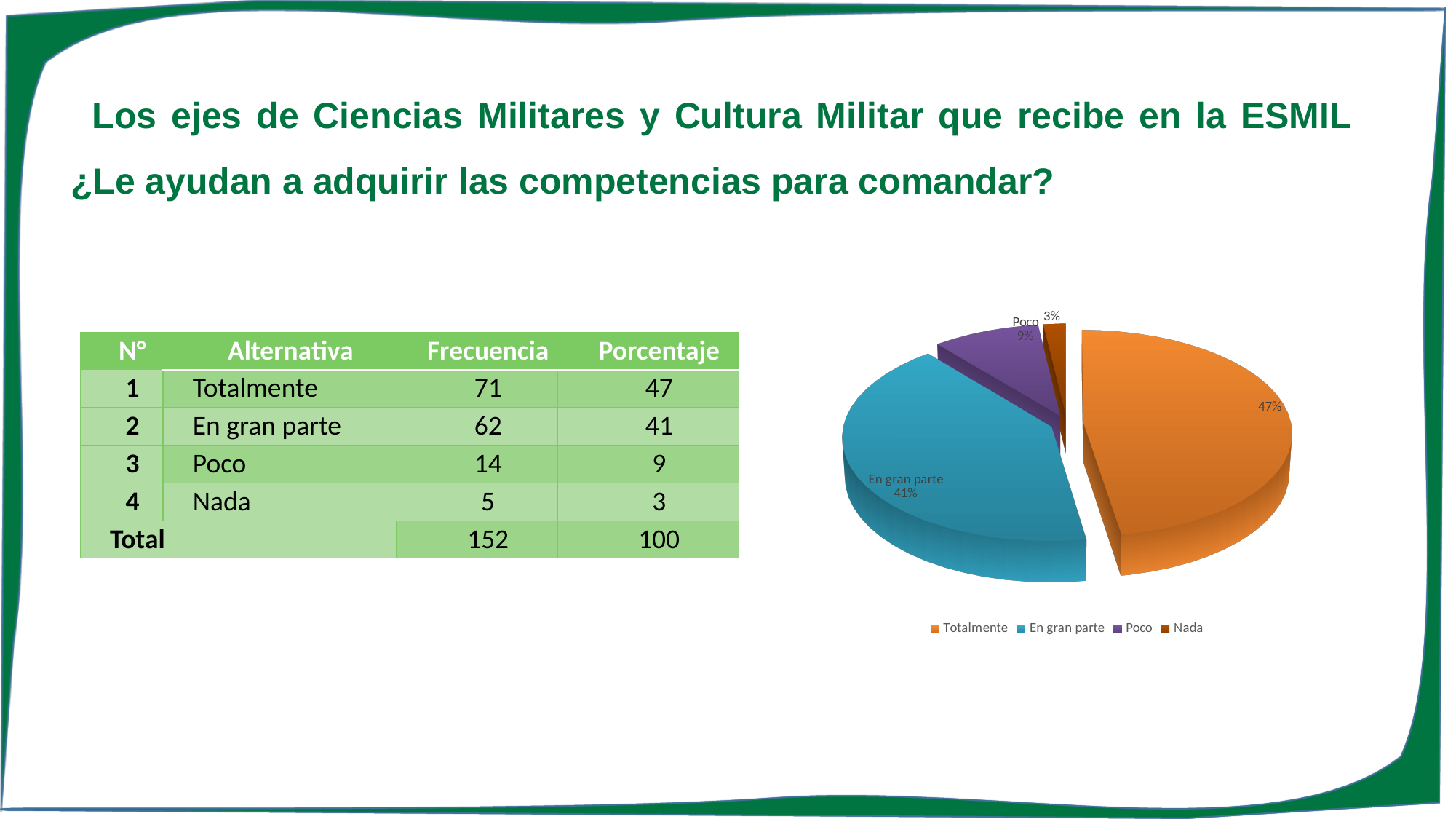
Which slice is larger in the pie chart, Poco or Nada? Poco Which category has the smallest slice in the pie chart? Nada What is the difference in percentage points between the Totalmente and En gran parte slices? 6 Which category has the largest slice in the pie chart? Totalmente What colour is the Totalmente slice in the pie chart? orange How many slices does the pie chart have? 4 What percentage does the Poco slice show in the pie chart? 9% What percentage does the En gran parte slice show in the pie chart? 41% How many entries does the legend of the pie chart list? 4 What kind of chart is shown on the slide? pie chart What percentage does the Totalmente slice show in the pie chart? 47% What percentage does the Nada slice show in the pie chart? 3%